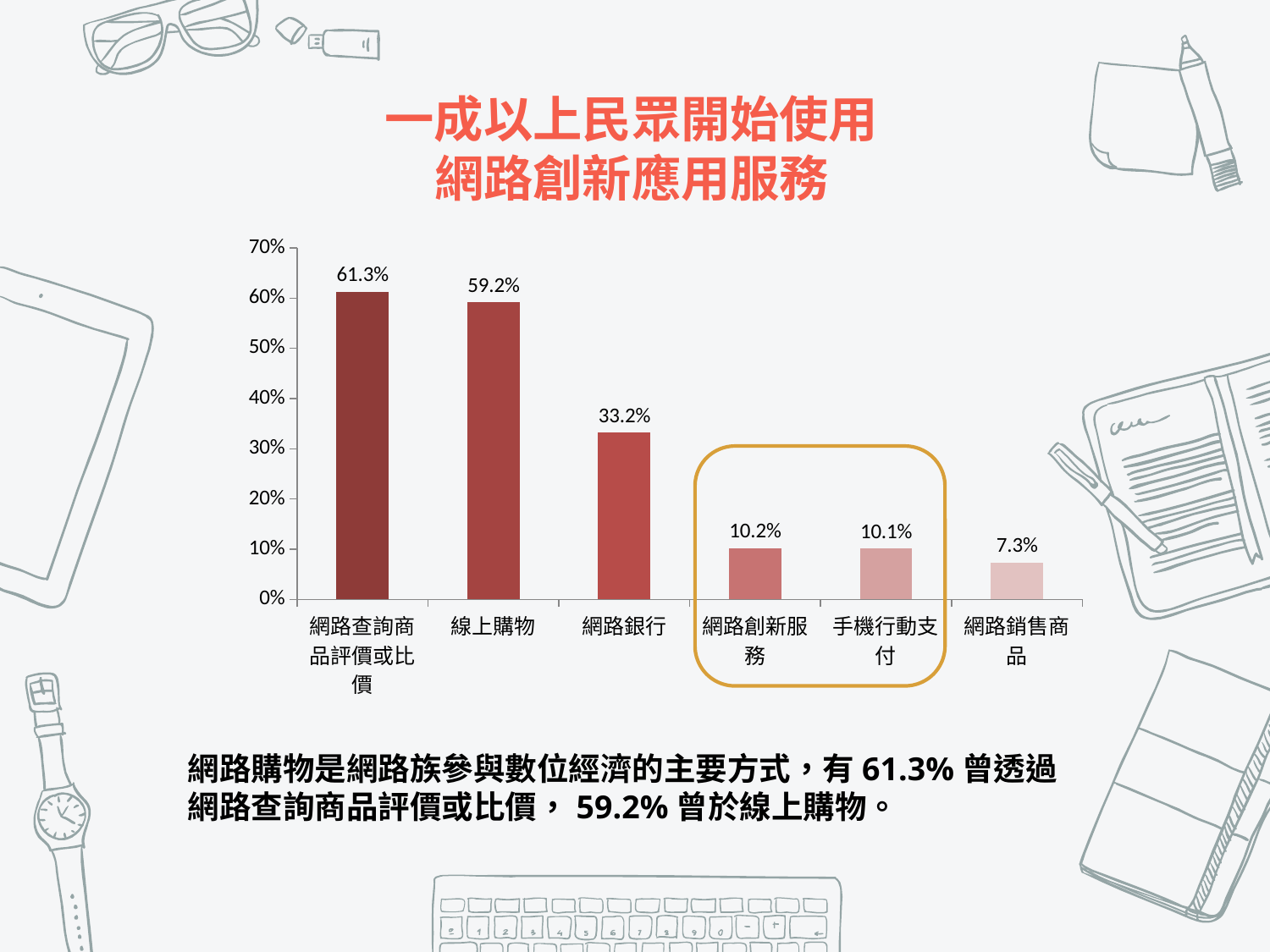
Which is larger, the value for 線上購物 or the value for 網路銀行? 線上購物 What kind of chart is shown on the slide? bar chart How many categories are shown in the chart? 6 Which category has the lowest value? 網路銷售商品 What is the value for 手機行動支付? 10.1% What is the value for 網路查詢商品評價或比價? 61.3% What is the difference between the values for 網路銀行 and 網路創新服務? 23.0 percentage points What is the value for 網路銀行? 33.2% What is the difference between the values for 網路查詢商品評價或比價 and 線上購物? 2.1 percentage points Which category has the highest value? 網路查詢商品評價或比價 What is the value for 線上購物? 59.2% Is the value for 網路銀行 greater or less than 30%? greater